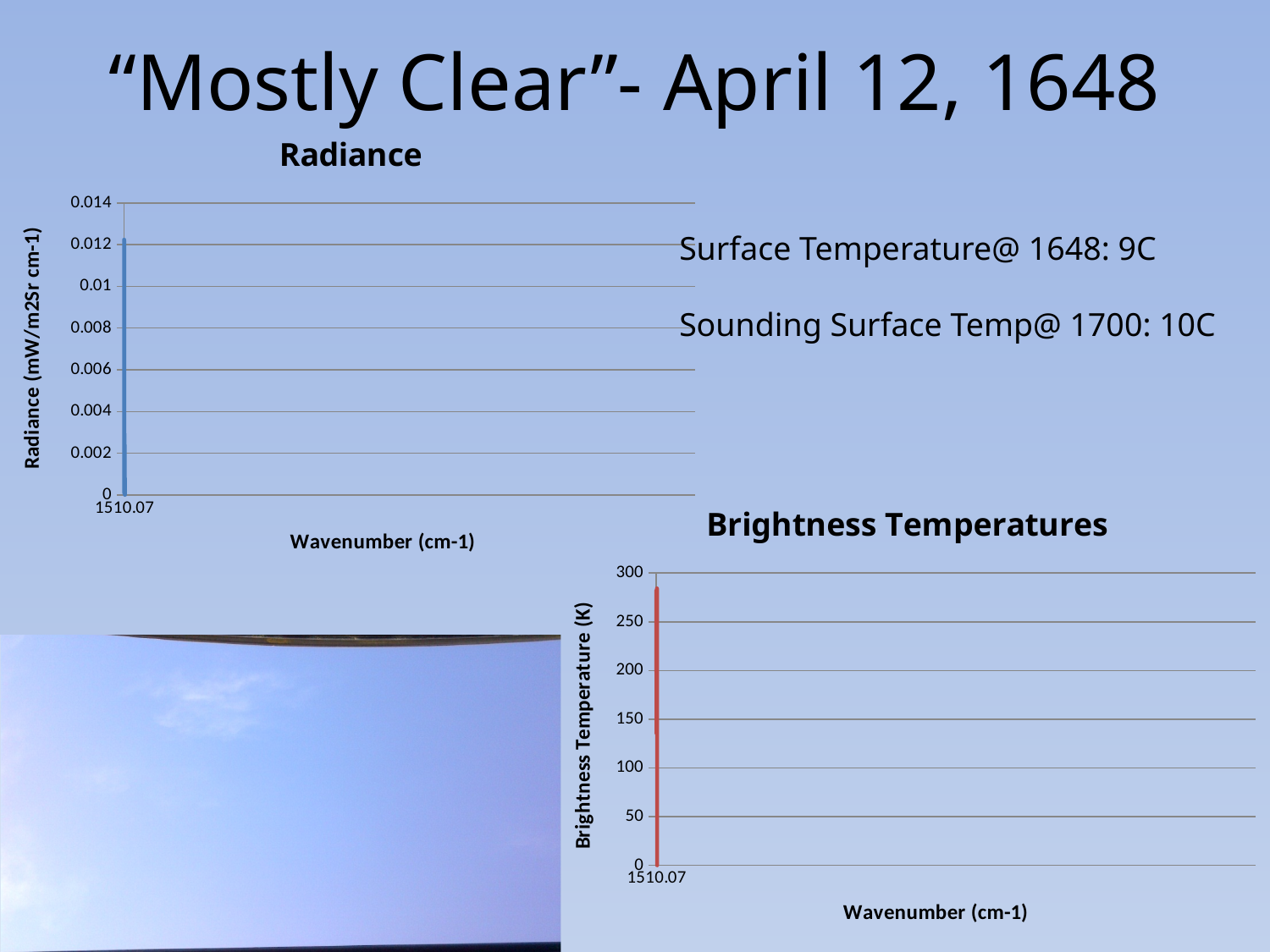
In the Brightness Temperatures chart, is the maximum plotted value greater or less than 300? less What is the title of the chart in the upper left of the slide? Radiance In the Radiance chart, is the maximum plotted value greater or less than 0.01? greater In the Brightness Temperatures chart, what is the only x-axis tick label shown? 1510.07 What is the title of the chart in the lower right of the slide? Brightness Temperatures In the Radiance chart, what is the only x-axis tick label shown? 1510.07 In the Brightness Temperatures chart, is the maximum plotted value greater or less than 250? greater In the Brightness Temperatures chart, what is the highest value shown on the y axis? 300 In the Radiance chart, what is the highest value shown on the y axis? 0.014